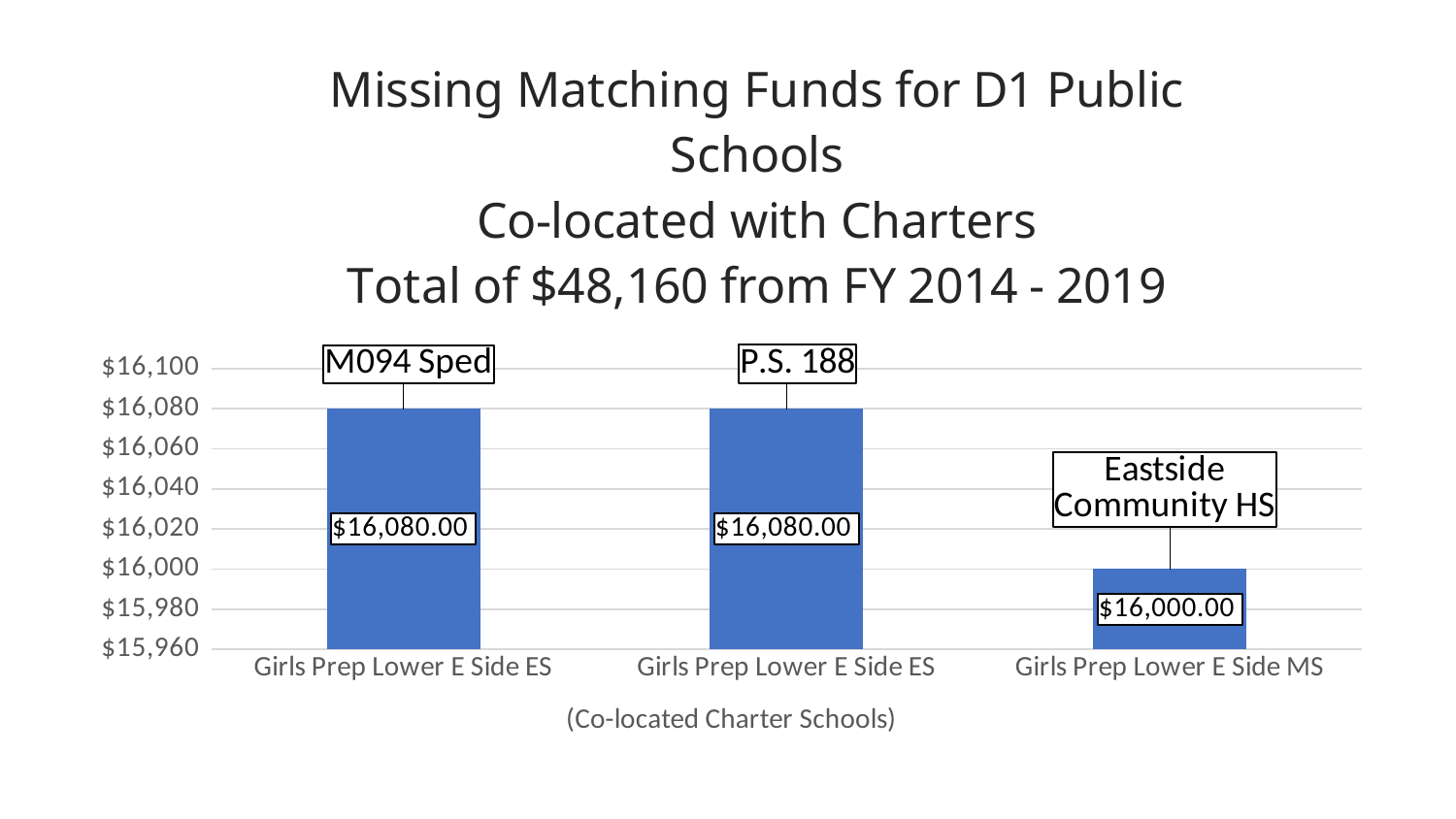
Which is larger, the value for P.S. 188 or the value for Eastside Community HS? P.S. 188 Which co-located charter school is listed on the x axis under the Eastside Community HS bar? Girls Prep Lower E Side MS What is the value of the bar labelled Eastside Community HS? $16,000.00 What is the value of the bar labelled P.S. 188? $16,080.00 How many bars are shown in the chart? 3 What kind of chart is shown on the slide? bar chart What is the value of the bar labelled M094 Sped? $16,080.00 Which school has the lowest missing matching funds? Eastside Community HS Is the value for Eastside Community HS greater or less than $16,040? less What is the total of the three bar values? $48,160.00 What is the difference between the value for M094 Sped and the value for Eastside Community HS? $80.00 What is the x-axis title of the chart? (Co-located Charter Schools)